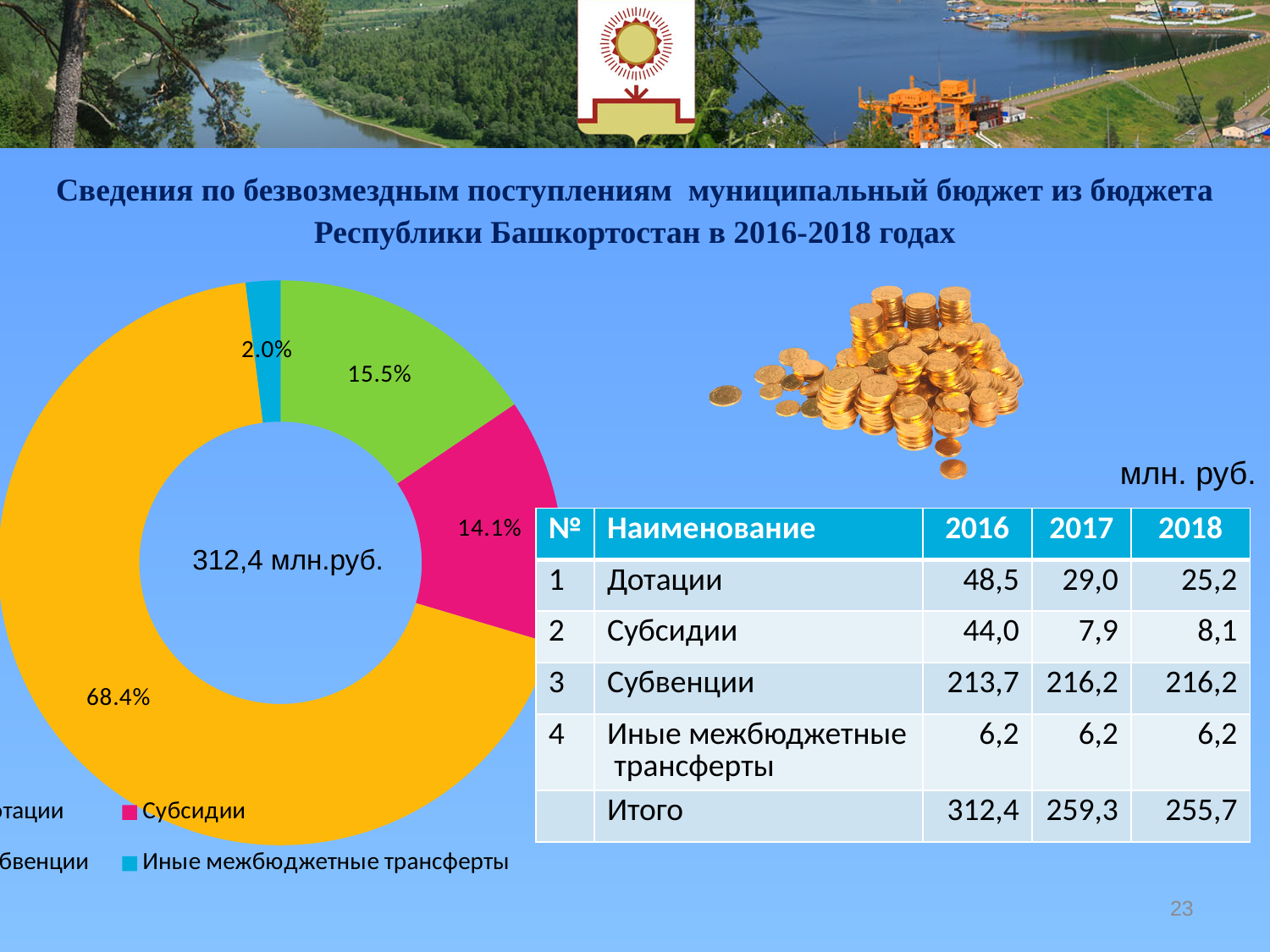
How many entries does the legend of the doughnut chart list? 4 What total amount is written in the centre of the doughnut chart? 312,4 млн.руб. What is the value of the smallest slice in the doughnut chart? 2.0% Which is larger in the doughnut chart: Субсидии or Иные межбюджетные трансферты? Субсидии What is the difference between the largest and smallest slices of the doughnut chart? 66.4 percentage points What kind of chart is shown on the left of the slide? Doughnut (pie) chart How many slices does the doughnut chart have? 4 What percentage does the doughnut chart show for Субсидии? 14.1% What percentage does the doughnut chart show for Иные межбюджетные трансферты? 2.0% What is the value of the largest slice in the doughnut chart? 68.4% By how many percentage points does Субсидии exceed Иные межбюджетные трансферты in the doughnut chart? 12.1 percentage points What colour is the Субсидии slice in the doughnut chart? Pink (magenta)